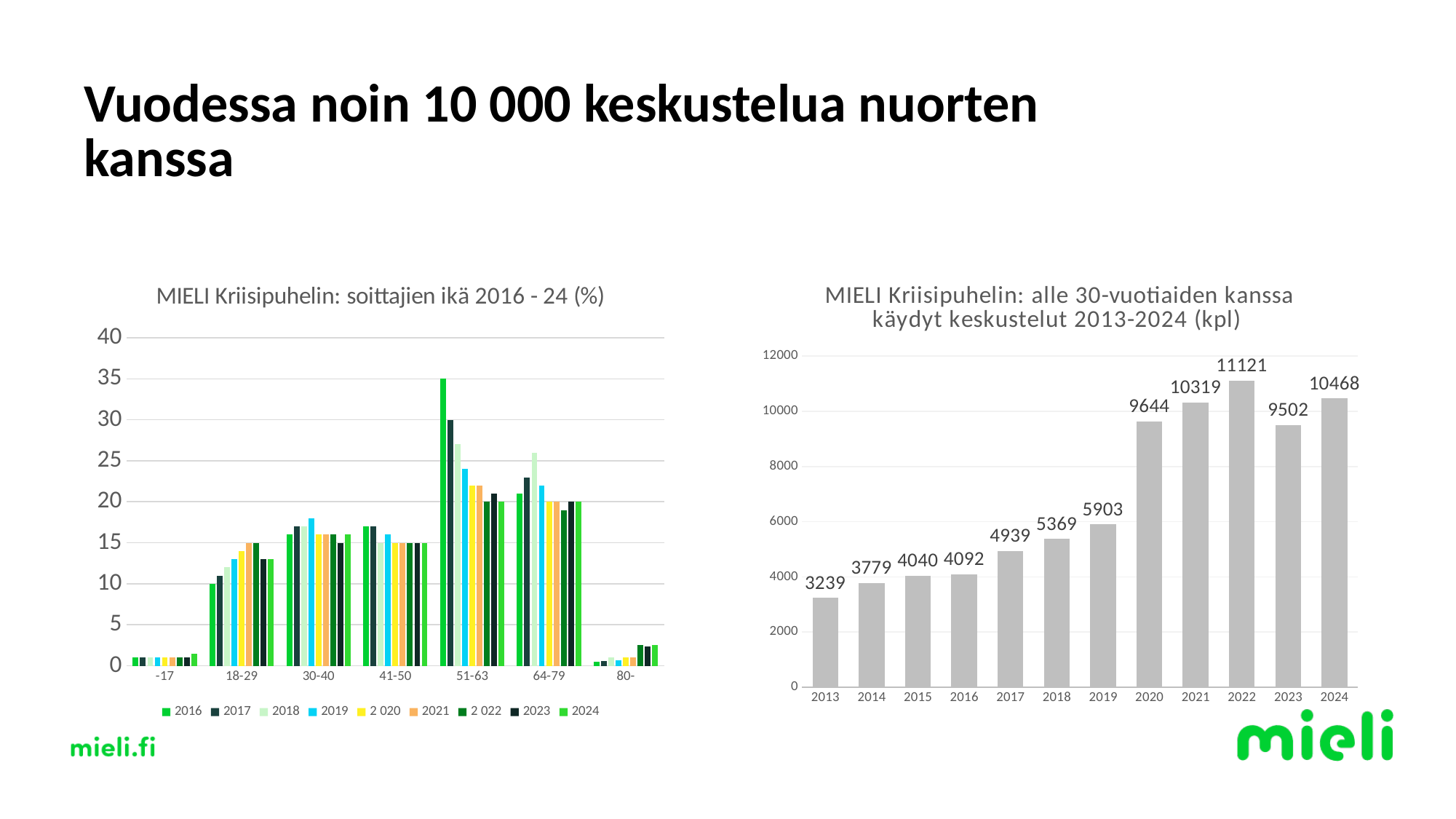
On the right chart (alle 30-vuotiaiden kanssa käydyt keskustelut), what is the value for 2013? 3239 On the right chart (alle 30-vuotiaiden kanssa käydyt keskustelut), what is the difference between the values for 2022 and 2021? 802 On the right chart (alle 30-vuotiaiden kanssa käydyt keskustelut), which is larger, the value for 2021 or the value for 2024? 2024 On the right chart (alle 30-vuotiaiden kanssa käydyt keskustelut), which year has the lowest value? 2013 On the left chart (soittajien ikä 2016 - 24), is the value for the 2016 series in the 51-63 age group greater or less than 30? greater On the right chart (alle 30-vuotiaiden kanssa käydyt keskustelut), which year has the highest value? 2022 On the left chart (soittajien ikä 2016 - 24), which age group has the highest value for the 2016 series? 51-63 On the right chart (alle 30-vuotiaiden kanssa käydyt keskustelut), what is the difference between the values for 2024 and 2023? 966 What kind of chart is the right chart (alle 30-vuotiaiden kanssa käydyt keskustelut)? bar chart On the left chart (soittajien ikä 2016 - 24), how many series does the legend list? 9 On the right chart (alle 30-vuotiaiden kanssa käydyt keskustelut), what is the value for 2022? 11121 On the right chart (alle 30-vuotiaiden kanssa käydyt keskustelut), how many years are shown on the x axis? 12